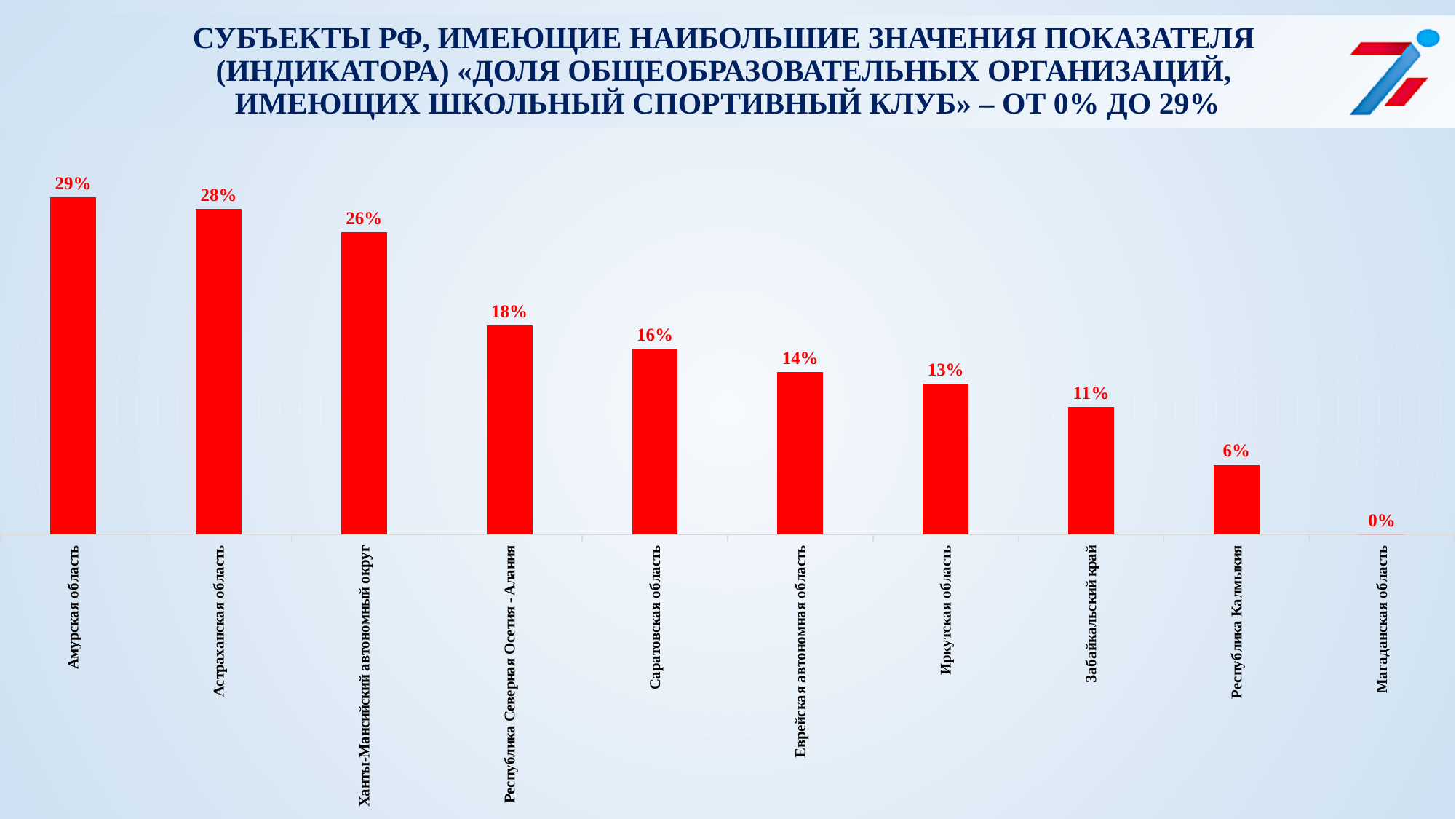
Do the values rise or fall from left to right along the x axis? Fall Which is larger, the value for Иркутская область or the value for Забайкальский край? Иркутская область What colour are the bars in the chart? Red Which category has the highest value? Амурская область How many categories are shown in the chart? 10 What kind of chart is shown on the slide? Bar chart What is the value for Республика Калмыкия? 6% What is the difference between the values for Ханты-Мансийский автономный округ and Республика Северная Осетия - Алания? 8% What is the value for Амурская область? 29% What is the value for Еврейская автономная область? 14% Which category has the lowest value? Магаданская область What is the value for Саратовская область? 16%